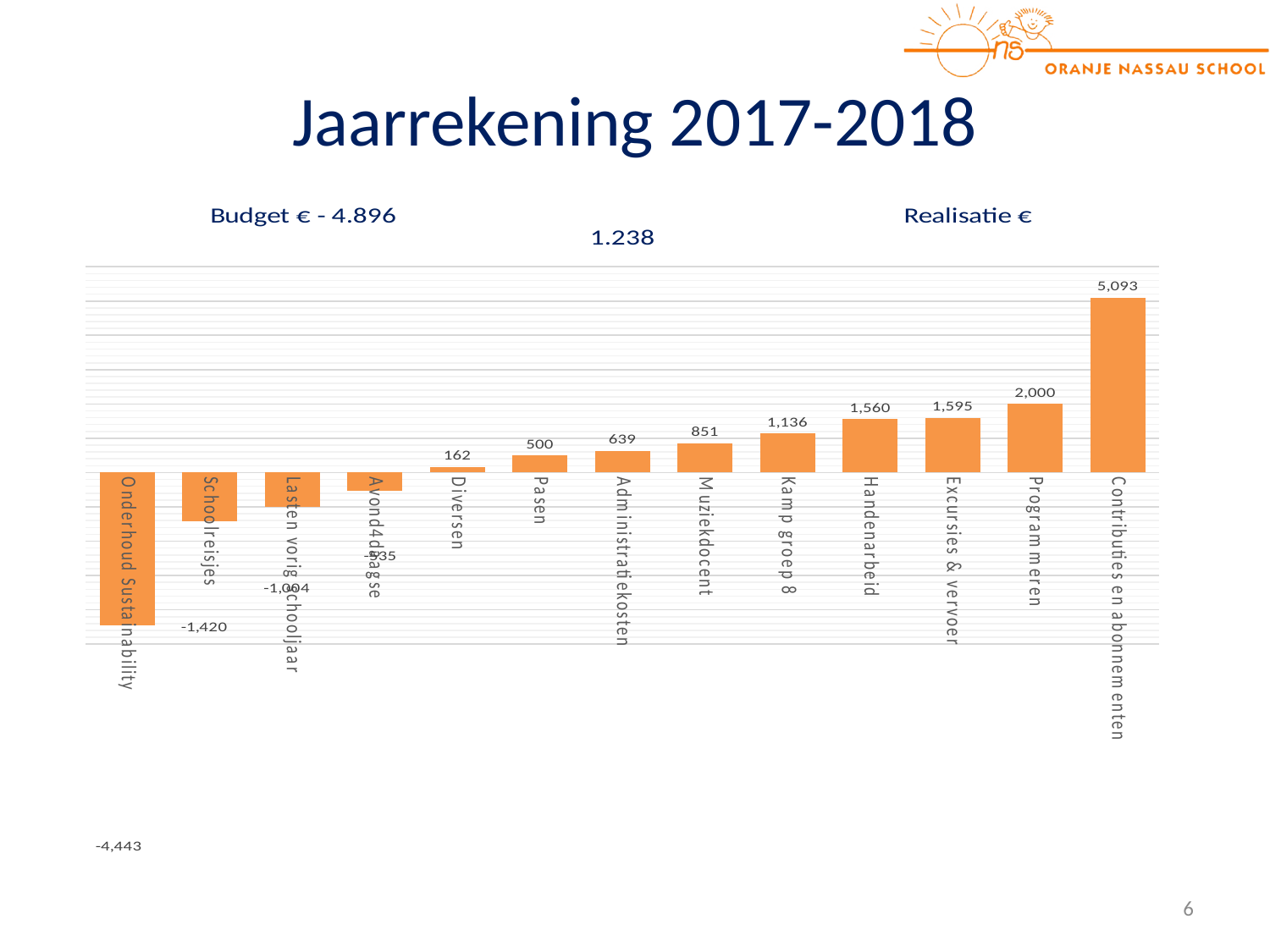
What is the value for Contributies en abonnementen? 5,093 What is the value for Programmeren? 2,000 What is the value for Onderhoud Sustainability? -4,443 Which is larger, the value for Kamp groep 8 or the value for Administratiekosten? Kamp groep 8 What kind of chart is shown on the slide? Bar chart What is the title of the slide containing the chart? Jaarrekening 2017-2018 What is the difference between the values for Programmeren and Pasen? 1,500 Which category has the highest value? Contributies en abonnementen How many categories are shown in the chart? 13 Which category has the lowest value? Onderhoud Sustainability What is the value for Schoolreisjes? -1,420 What is the value for Muziekdocent? 851